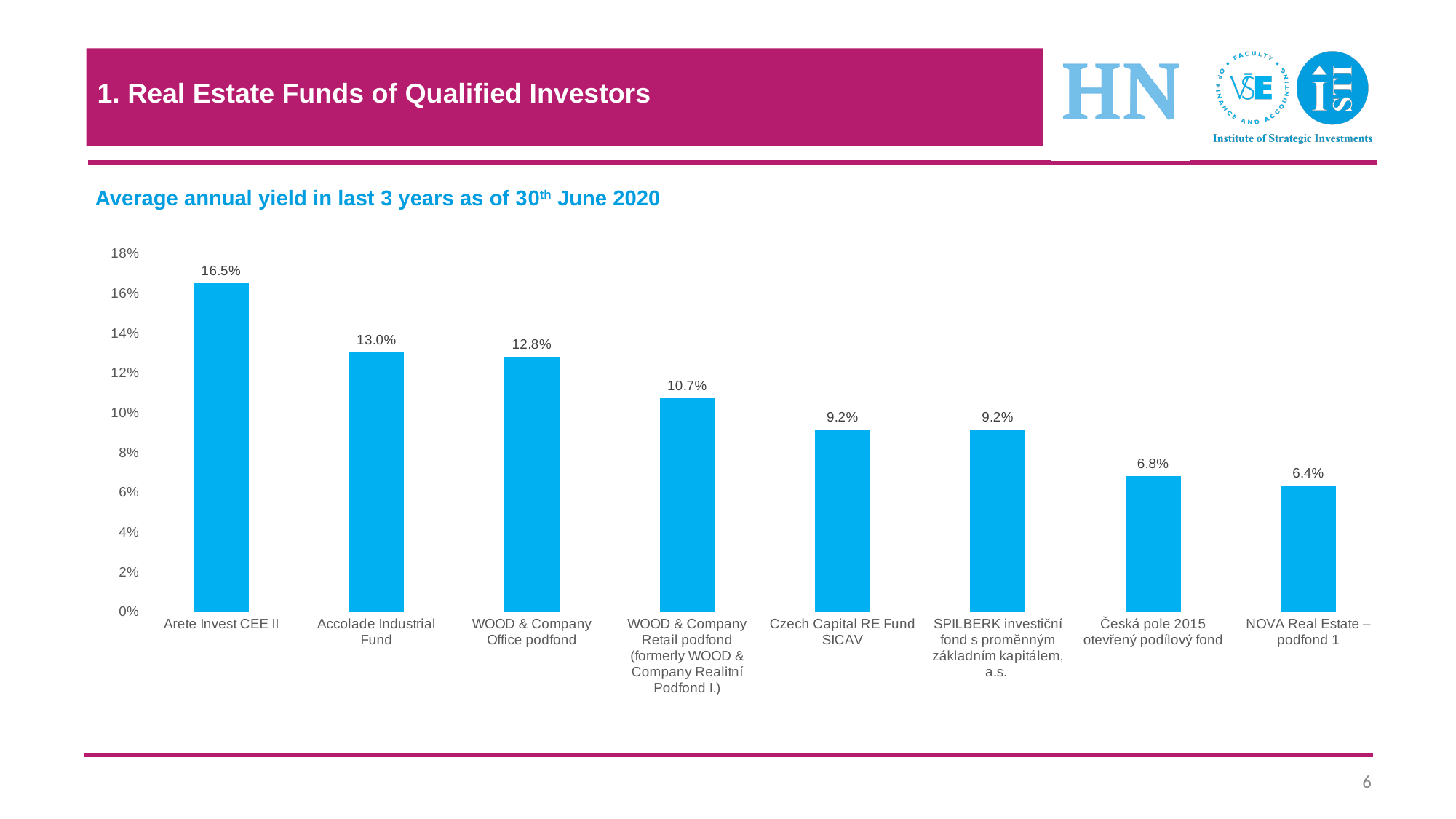
Which fund has the lowest average annual yield? NOVA Real Estate – podfond 1 What is the difference between the yields of Arete Invest CEE II and Accolade Industrial Fund? 3.5% What is the difference between the yields of WOOD & Company Office podfond and WOOD & Company Retail podfond? 2.1% What is the title of the chart? Average annual yield in last 3 years as of 30th June 2020 What is the average annual yield for NOVA Real Estate – podfond 1? 6.4% What is the average annual yield for Arete Invest CEE II? 16.5% Which fund has the highest average annual yield? Arete Invest CEE II What is the average annual yield for Accolade Industrial Fund? 13.0% Which has a higher yield, Česká pole 2015 otevřený podílový fond or NOVA Real Estate – podfond 1? Česká pole 2015 otevřený podílový fond What kind of chart is shown on the slide? Bar chart What is the average annual yield for Czech Capital RE Fund SICAV? 9.2% How many funds are shown in the chart? 8